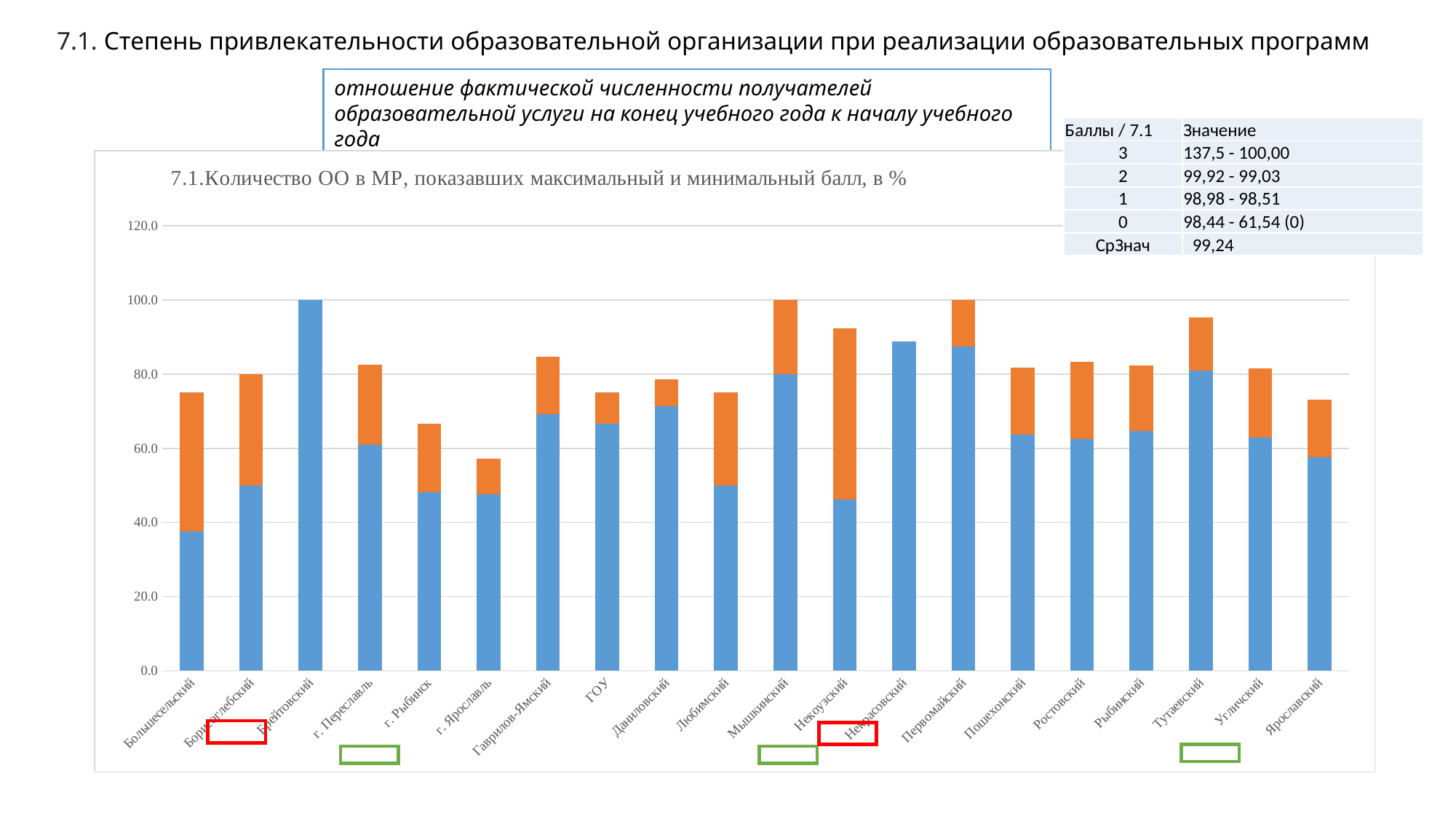
What kind of chart is shown on the slide? bar chart Is the blue segment for Мышкинский greater or less than 60? greater Is the total bar height for г. Ярославль greater or less than 60? less Which has the taller total bar, Тутаевский or Ярославский? Тутаевский What is the title of the chart? 7.1.Количество ОО в МР, показавших максимальный и минимальный балл, в % What two colours are used for the bar segments in the chart? blue and orange Which category has the lowest total bar height in the chart? г. Ярославль How many categories (municipal districts) are shown on the x axis of the chart? 20 Which category has the tallest blue segment in the chart? Брейтовский Is the total bar height for Некрасовский greater or less than 100? less Which category has the shortest blue segment in the chart? Большесельский